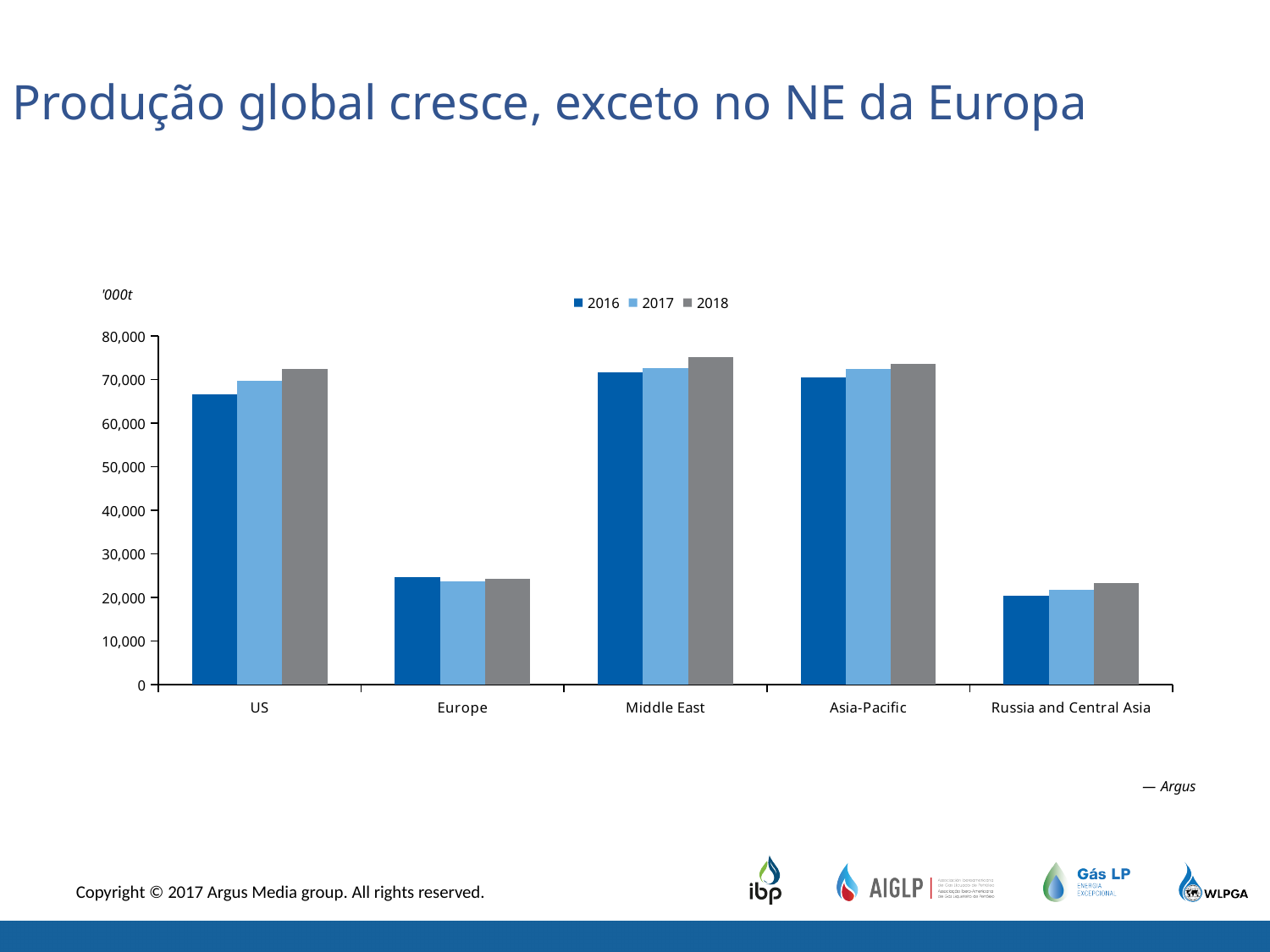
Do the US bars rise or fall from 2016 to 2018? rise Which region has the lowest values across all three years? Russia and Central Asia What kind of chart is shown on the slide? bar chart How many regions are shown on the x axis? 5 Is the value for Middle East in 2018 greater or less than 70,000? greater Is the value for US in 2016 greater or less than 60,000? greater Is the value for Russia and Central Asia in 2016 greater or less than 30,000? less How many series does the legend list? 3 Which is larger, the 2016 value for US or the 2016 value for Europe? US What are the three legend entries? 2016, 2017, 2018 What unit is shown at the top left of the chart? '000t